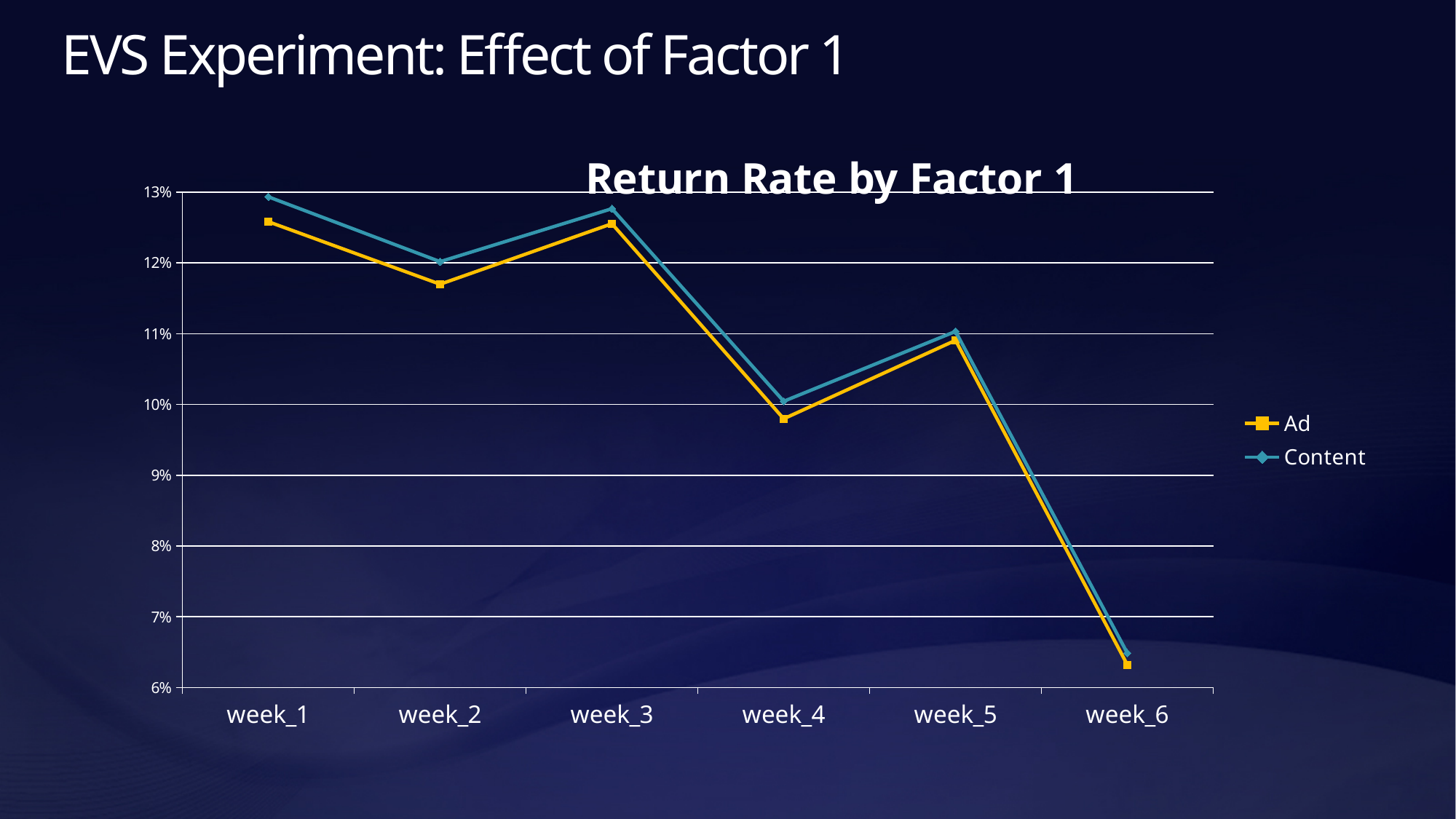
Is the Content return rate for week_6 greater or less than 7%? less Is the Ad return rate for week_4 greater or less than 10%? less At week_2, which series has the higher return rate, Ad or Content? Content What is the title of the chart? Return Rate by Factor 1 Is the Ad return rate for week_1 greater or less than 12%? greater Overall, do the return rates rise or fall from week_1 to week_6? fall How many series does the legend list? 2 What kind of chart is shown on the slide? line chart Which week has the lowest return rate for the Ad series? week_6 Which week has the highest return rate for the Content series? week_1 How many weeks are plotted along the x axis? 6 Which series is drawn in yellow? Ad